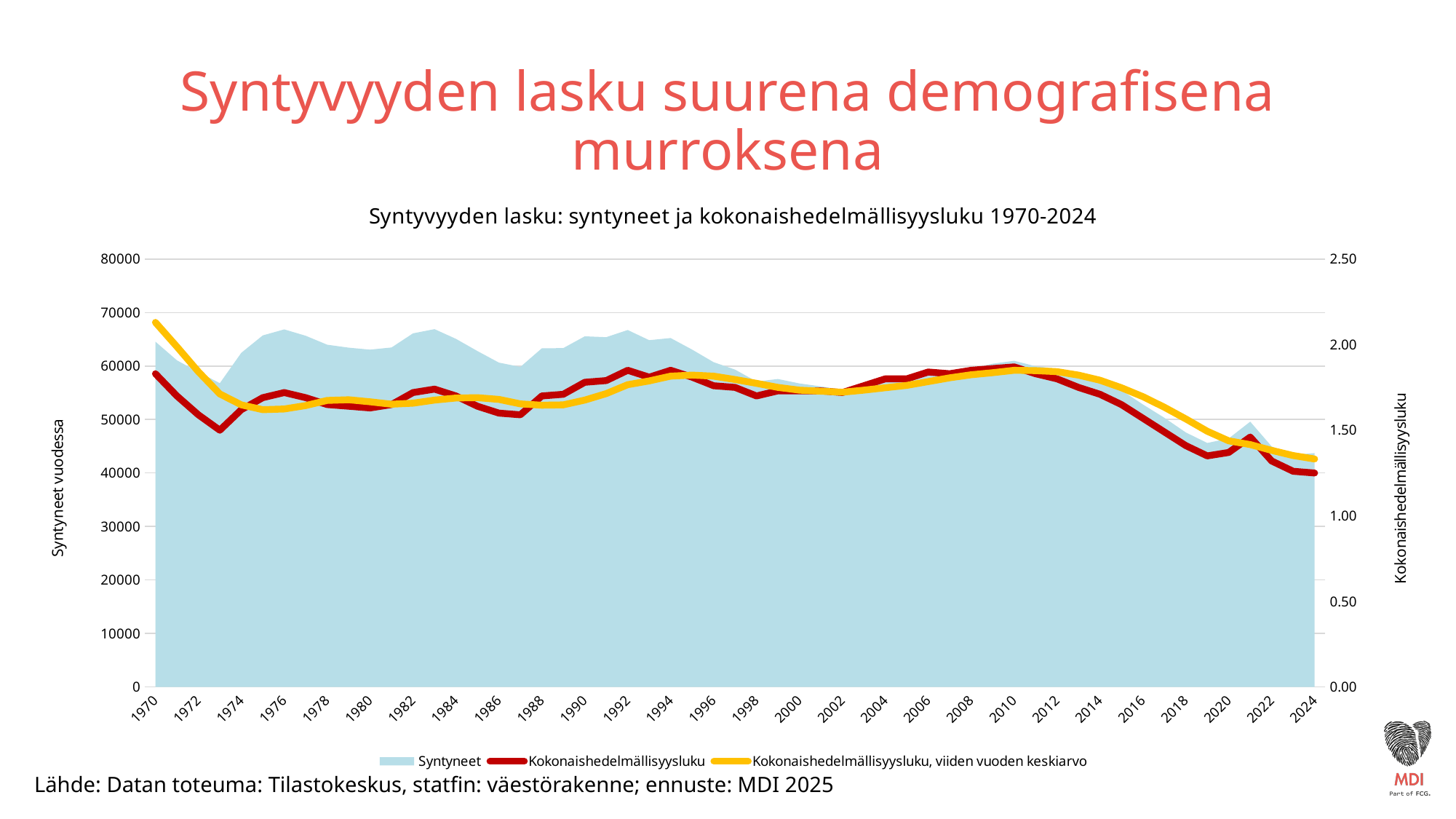
How many series does the legend list? 3 Is the Kokonaishedelmällisyysluku in 2024 greater or less than 1.50? less What colour is the Syntyneet series in the chart? light blue Is the value of Syntyneet in 1970 greater or less than 60000? greater Is the value of Syntyneet in 2024 greater or less than 50000? less Which year has the higher Kokonaishedelmällisyysluku, 1970 or 1973? 1970 Do the values of Syntyneet rise or fall from 2010 to 2024? fall What is the title of the chart? Syntyvyyden lasku: syntyneet ja kokonaishedelmällisyysluku 1970-2024 Which year has the larger value of Syntyneet, 1970 or 2024? 1970 What kind of chart is shown on the slide? area and line chart